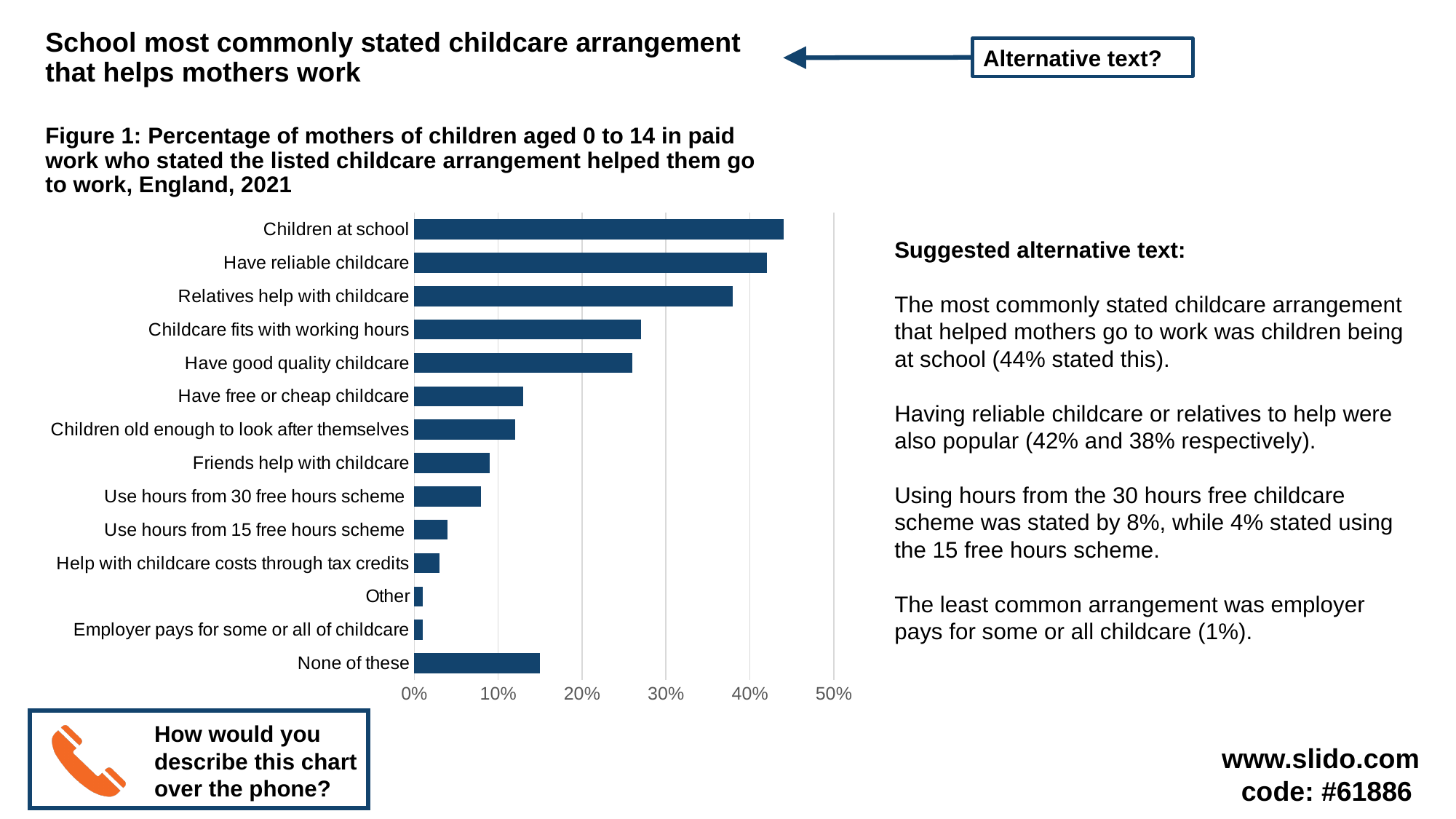
Which is larger: the value for 'Have reliable childcare' or for 'Relatives help with childcare'? Have reliable childcare What is the highest value shown on the horizontal axis of the chart? 50% What kind of chart is shown in Figure 1? bar chart What is the difference in percentage points between 'Have reliable childcare' and 'Relatives help with childcare'? 4 percentage points What percentage of mothers stated that having reliable childcare helped them go to work? 42% What percentage of mothers stated that children being at school helped them go to work? 44% Is the value for 'Childcare fits with working hours' greater or less than 20%? greater Is the value for 'Friends help with childcare' greater or less than 10%? less How many childcare arrangement categories are plotted in the chart? 14 Is the value for 'None of these' greater or less than 10%? greater What percentage of mothers stated using hours from the 15 free hours scheme? 4% Which childcare arrangement has the highest percentage in the chart? Children at school